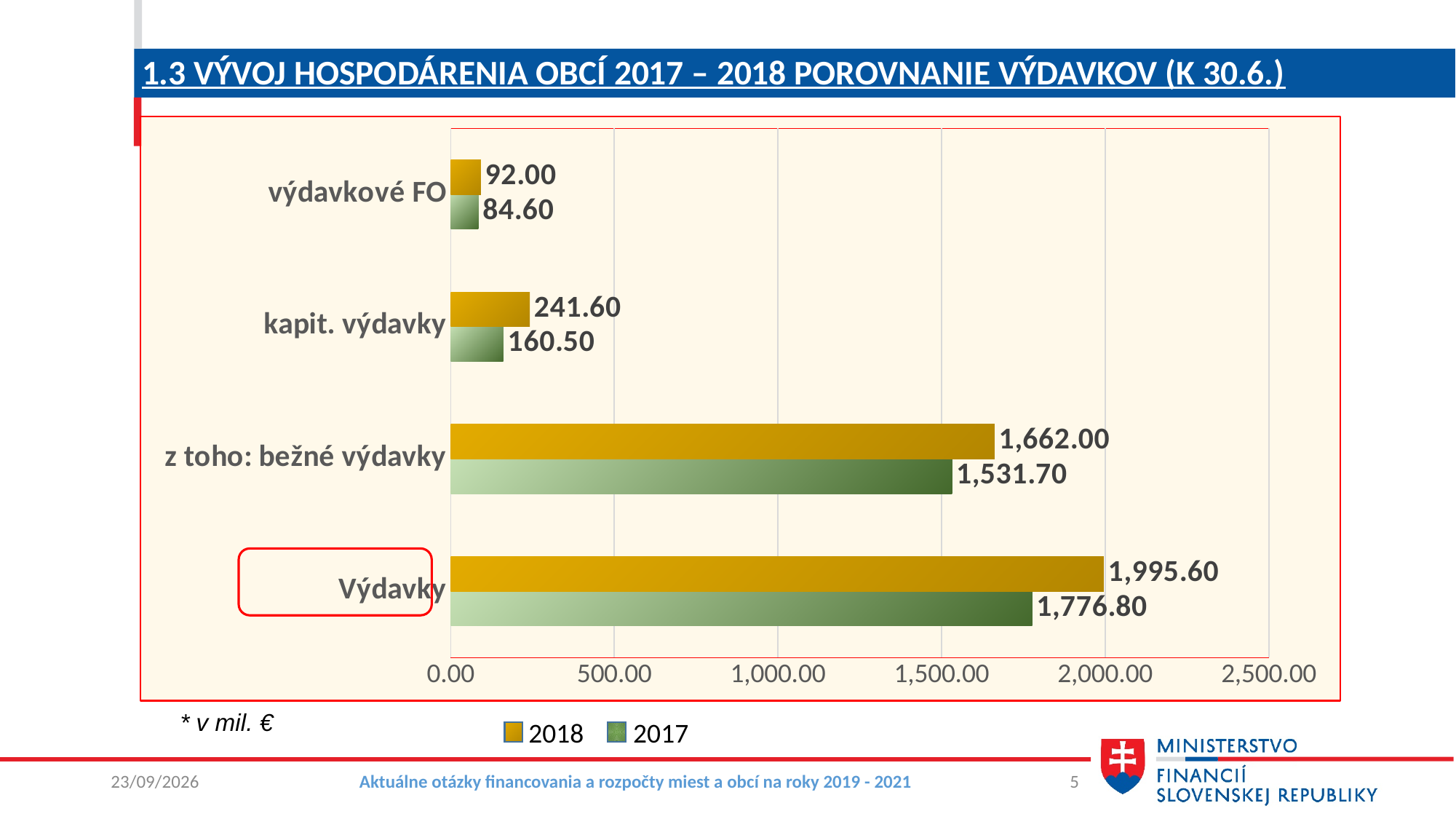
How many series does the legend list? 2 What is the 2017 value for kapit. výdavky? 160.50 Which category has the highest 2018 value? Výdavky For z toho: bežné výdavky, which year has the larger value, 2018 or 2017? 2018 What is the 2018 value for Výdavky? 1,995.60 Which category has the lowest 2017 value? výdavkové FO What is the 2018 value for výdavkové FO? 92.00 What is the difference between the 2018 and 2017 values for Výdavky? 218.80 What kind of chart is shown on the slide? Bar chart How many categories are shown on the chart? 4 What is the 2017 value for z toho: bežné výdavky? 1,531.70 What is the difference between the 2018 and 2017 values for kapit. výdavky? 81.10